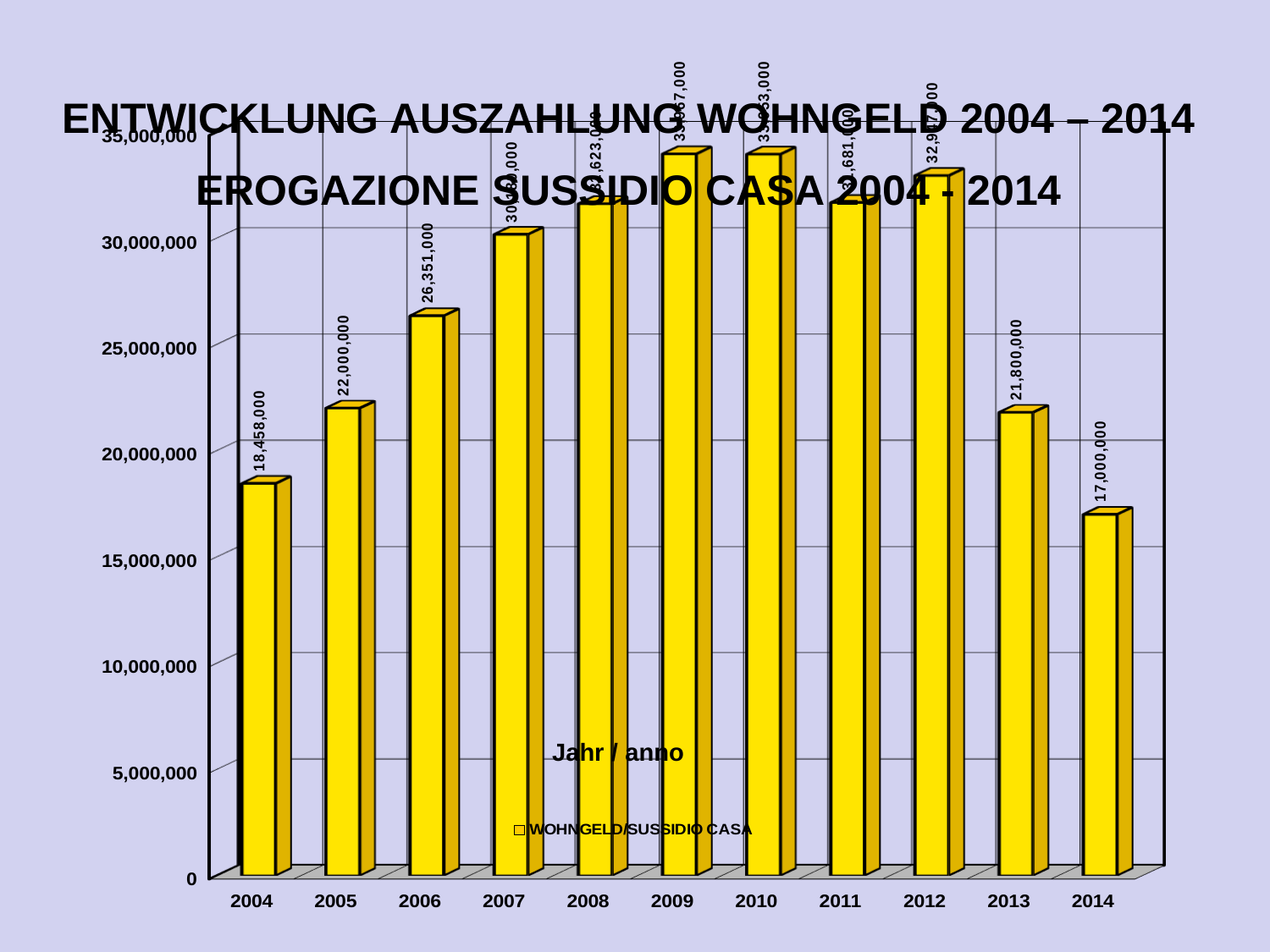
What is the difference between the values for 2013 and 2014? 4,800,000 Is the value for 2012 greater or less than 30,000,000? greater Which year has the lowest value? 2014 What is the value for 2014? 17,000,000 Which is larger, the value for 2006 or the value for 2013? 2006 What is the difference between the values for 2005 and 2004? 3,542,000 What is the value for 2006? 26,351,000 What is the value for 2004? 18,458,000 What is the value for 2013? 21,800,000 Is the value for 2007 greater or less than 25,000,000? greater How many years are shown on the x axis? 11 What kind of chart is shown on the slide? bar chart